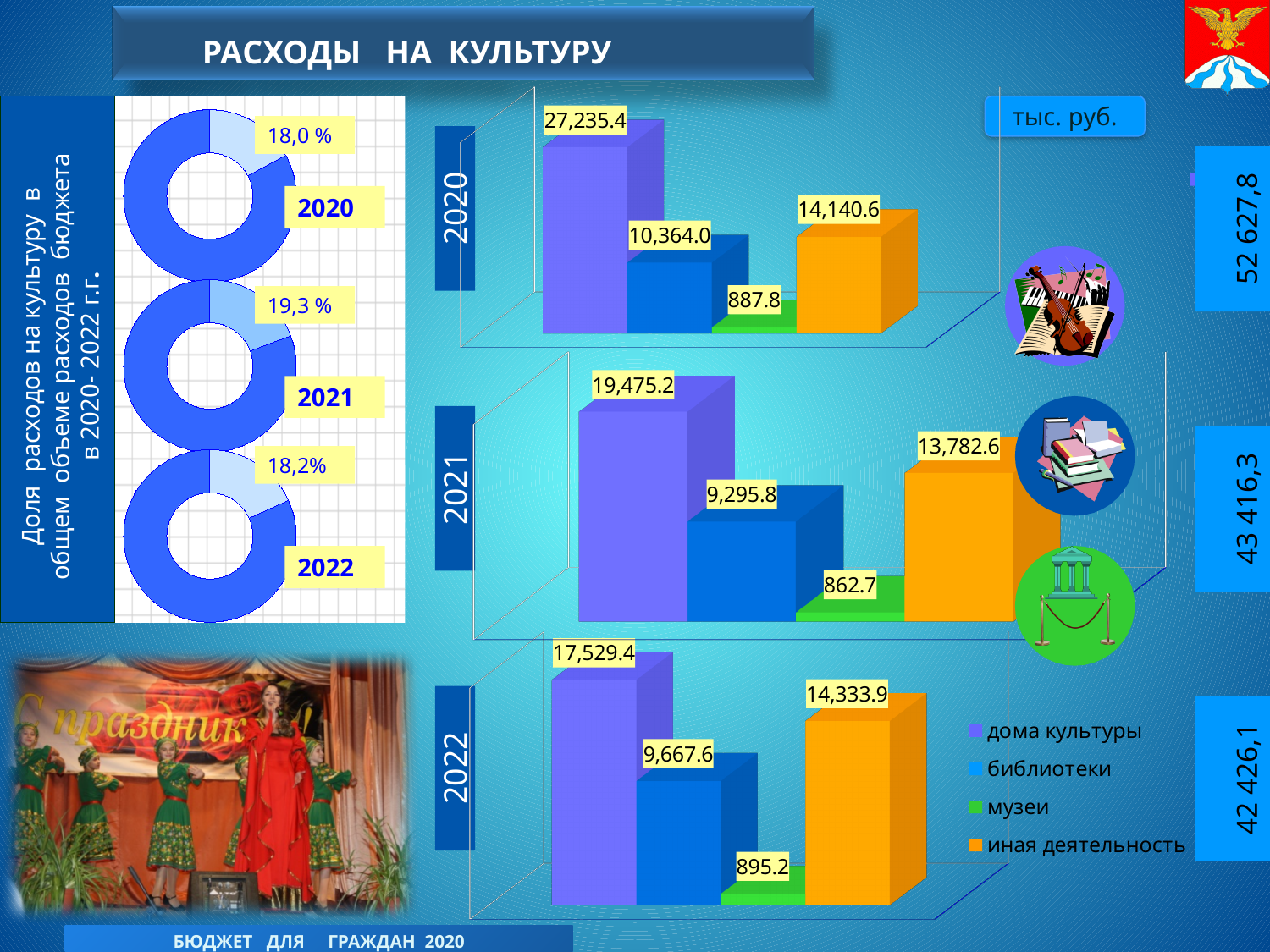
In the 2020 bar chart, what is the value for дома культуры? 27,235.4 In the 2021 bar chart, which category has the lowest value? музеи In the 2022 bar chart, which is larger: библиотеки or иная деятельность? иная деятельность In the donut chart for 2020, what share is shown for culture expenses? 18,0 % What unit is stated for the values in the bar charts? тыс. руб. In the 2022 bar chart, what is the value for иная деятельность? 14,333.9 In the 2020 bar chart, what is the difference between дома культуры and иная деятельность? 13,094.8 In the 2021 bar chart, what is the value for библиотеки? 9,295.8 In the 2022 bar chart, what is the value for музеи? 895.2 In the donut chart for 2021, what share of total budget expenses goes to culture? 19,3 % How many series does the legend of the bar charts list? 4 In the 2020 bar chart, which category has the highest value? дома культуры